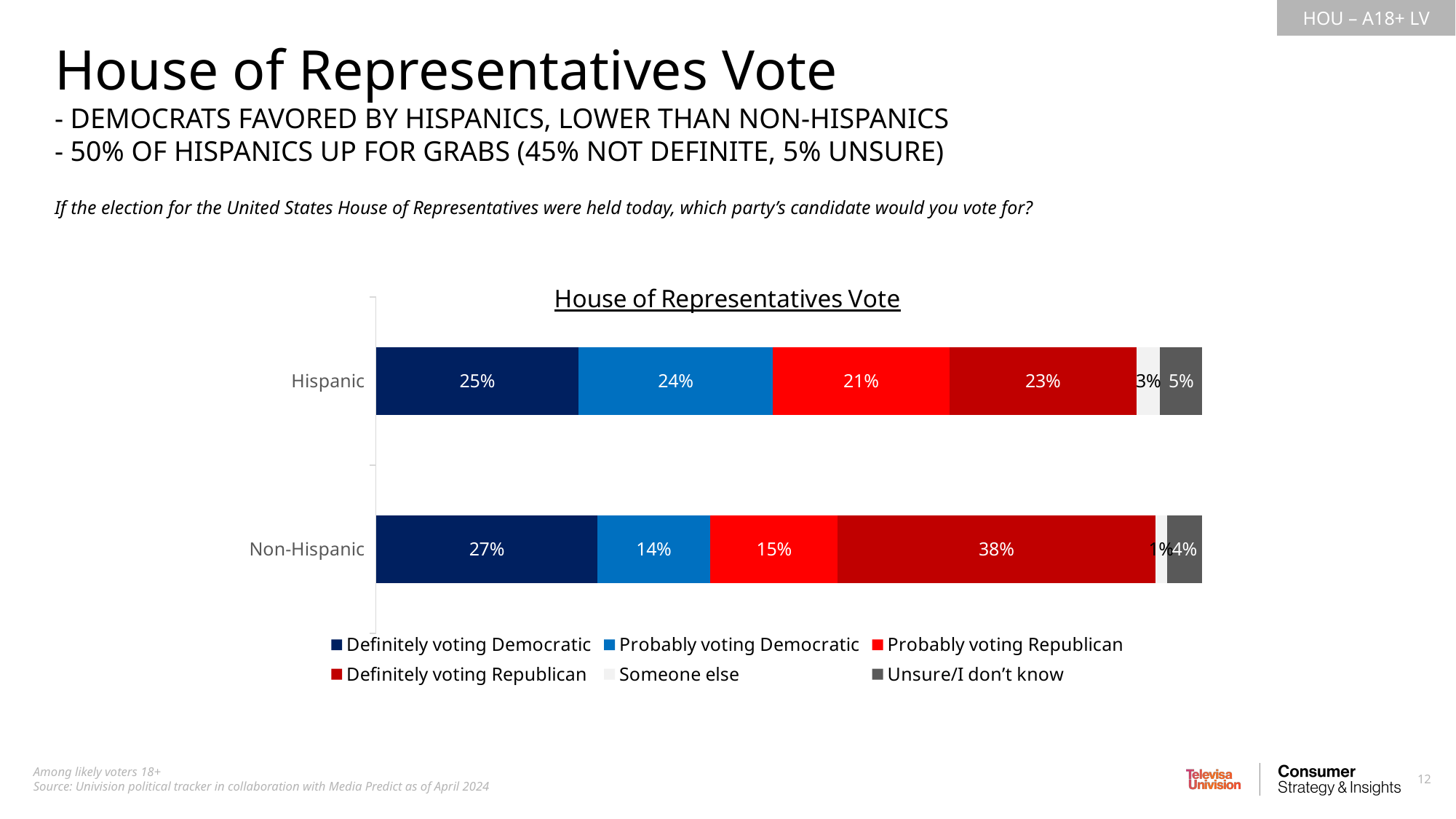
What is the value for Probably voting Democratic among Non-Hispanic voters? 14% Which response category has the largest share among Non-Hispanic voters? Definitely voting Republican What is the value for Unsure/I don't know among Hispanic voters? 5% How many series does the legend list? 6 What kind of chart is shown on the slide? Stacked bar chart What percentage of Non-Hispanic likely voters are definitely voting Republican? 38% What is the difference between the Definitely voting Republican shares for Non-Hispanic and Hispanic voters? 15% What percentage of Hispanic likely voters are definitely voting Democratic? 25% What is the title of the chart? House of Representatives Vote Which group has a larger share for Probably voting Democratic, Hispanic or Non-Hispanic? Hispanic How many groups (bars) are shown in the chart? 2 Which response category has the smallest share among Non-Hispanic voters? Someone else